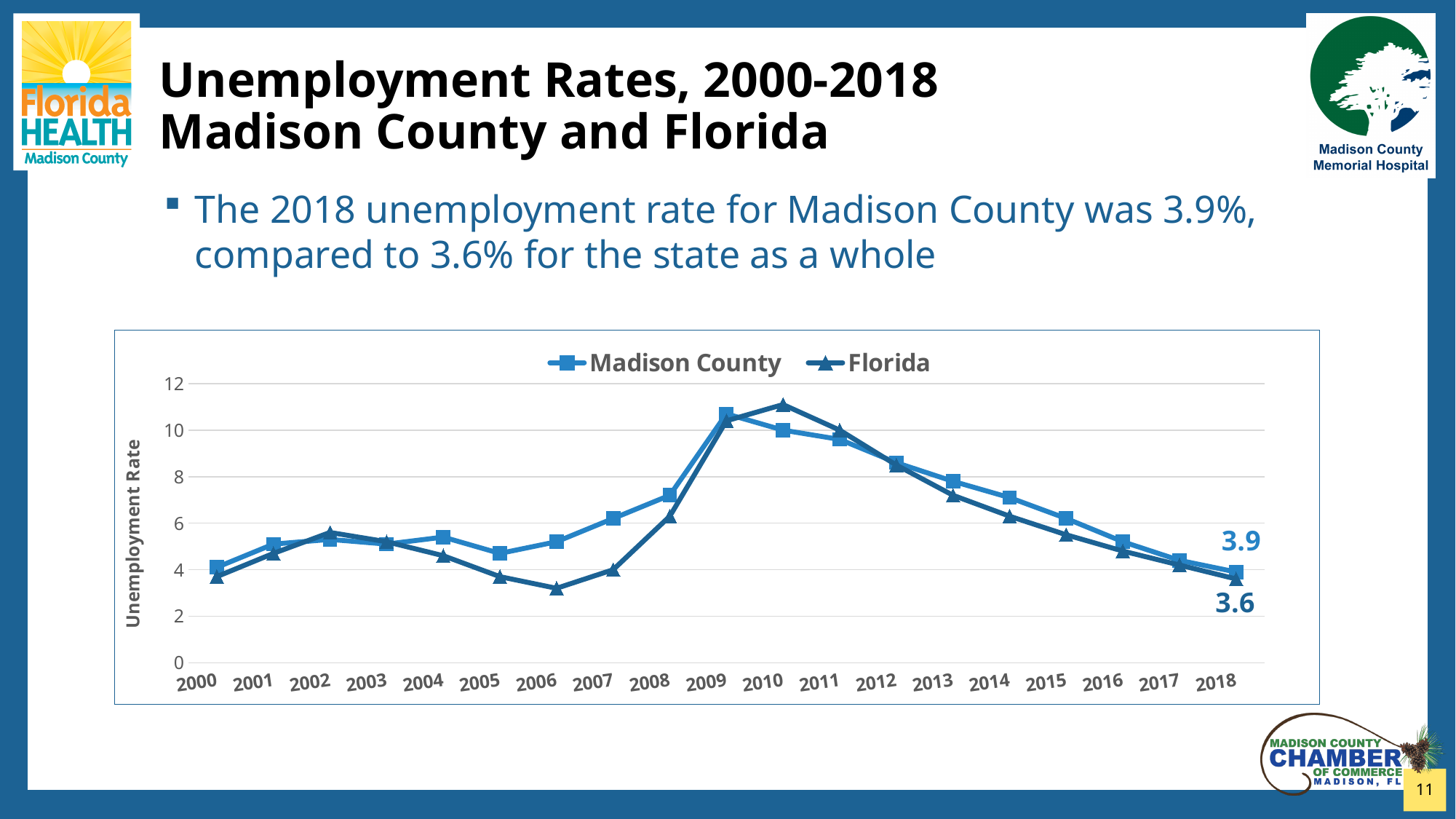
In 2018, which series has the higher unemployment rate, Madison County or Florida? Madison County Does the Madison County unemployment rate rise or fall from 2012 to 2018? fall What is the Madison County unemployment rate for 2018 shown on the chart? 3.9 What kind of chart is shown on the slide? line chart How many years are plotted along the x axis of the chart? 19 In which year does the Madison County series reach its highest unemployment rate? 2009 Is the Florida unemployment rate for 2010 greater or less than 10? greater How many series does the chart's legend list? 2 Is the Florida unemployment rate for 2006 greater or less than 4? less What is the difference between the Madison County and Florida unemployment rates in 2018? 0.3 What is the Florida unemployment rate for 2018 shown on the chart? 3.6 In which year does the Florida series reach its highest unemployment rate? 2010